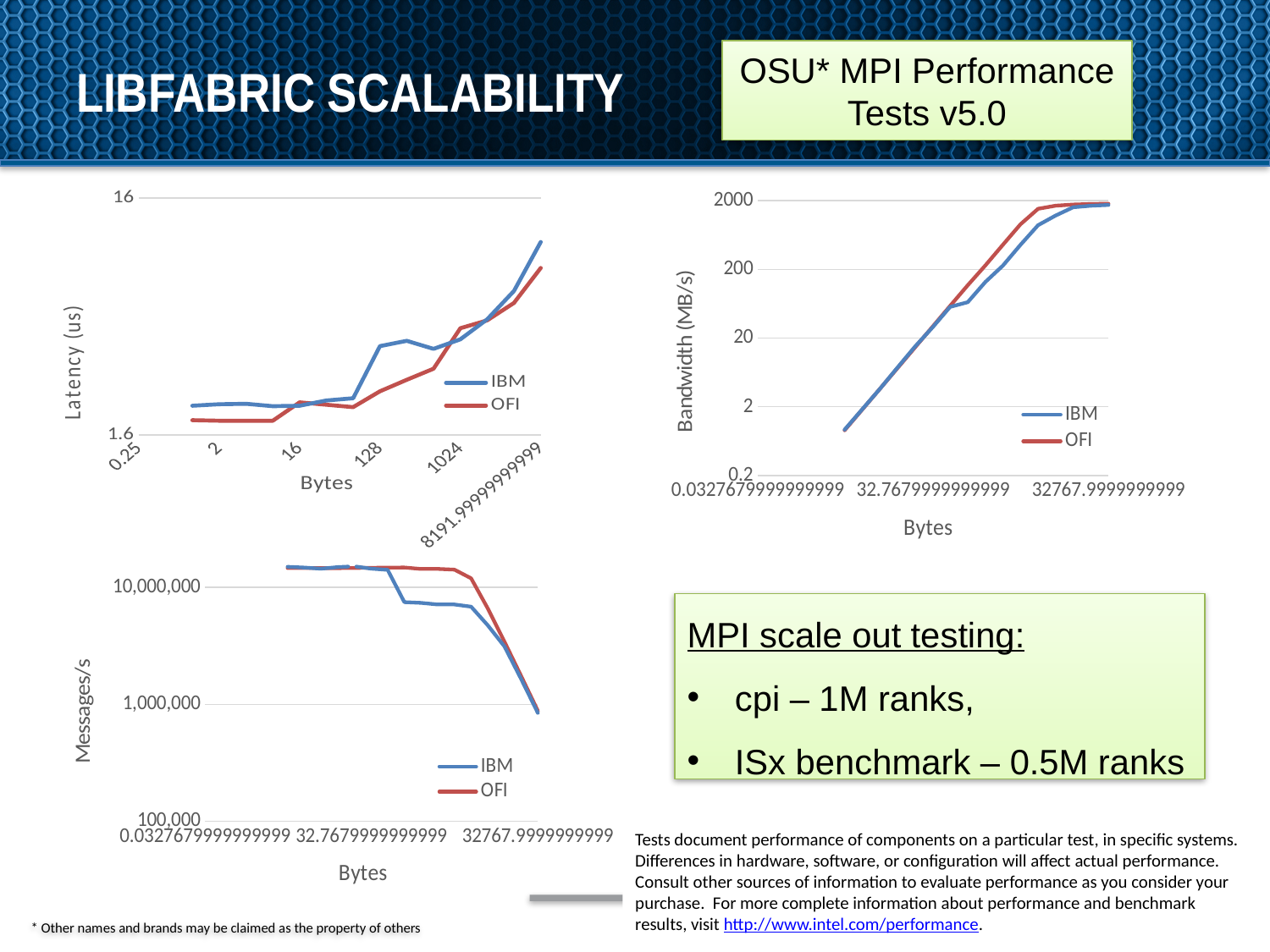
What kind of chart is the top-left chart with the Latency (us) axis? line chart In the bottom-left Messages/s chart, is the value at the smallest byte size greater or less than 10,000,000? greater In the top-left latency chart, do the latency values rise or fall as the number of bytes increases? rise Which two series are listed in the legend of the top-right bandwidth chart? IBM and OFI In the top-left latency chart, is the IBM latency at the largest byte size greater or less than 16? less In the top-right bandwidth chart, do the bandwidth values rise or fall as the number of bytes increases? rise In the bottom-left Messages/s chart, do the values rise or fall as the number of bytes increases? fall In the top-right bandwidth chart, which series has the higher bandwidth around 32.768 to 32767 bytes, IBM or OFI? OFI How many series does the legend of the top-left latency chart list? 2 In the top-left latency chart, what is the title of the x axis? Bytes In the top-right bandwidth chart, is the bandwidth at the largest byte size greater or less than 200? greater In the top-left latency chart, which series has the higher latency at 128 bytes, IBM or OFI? IBM